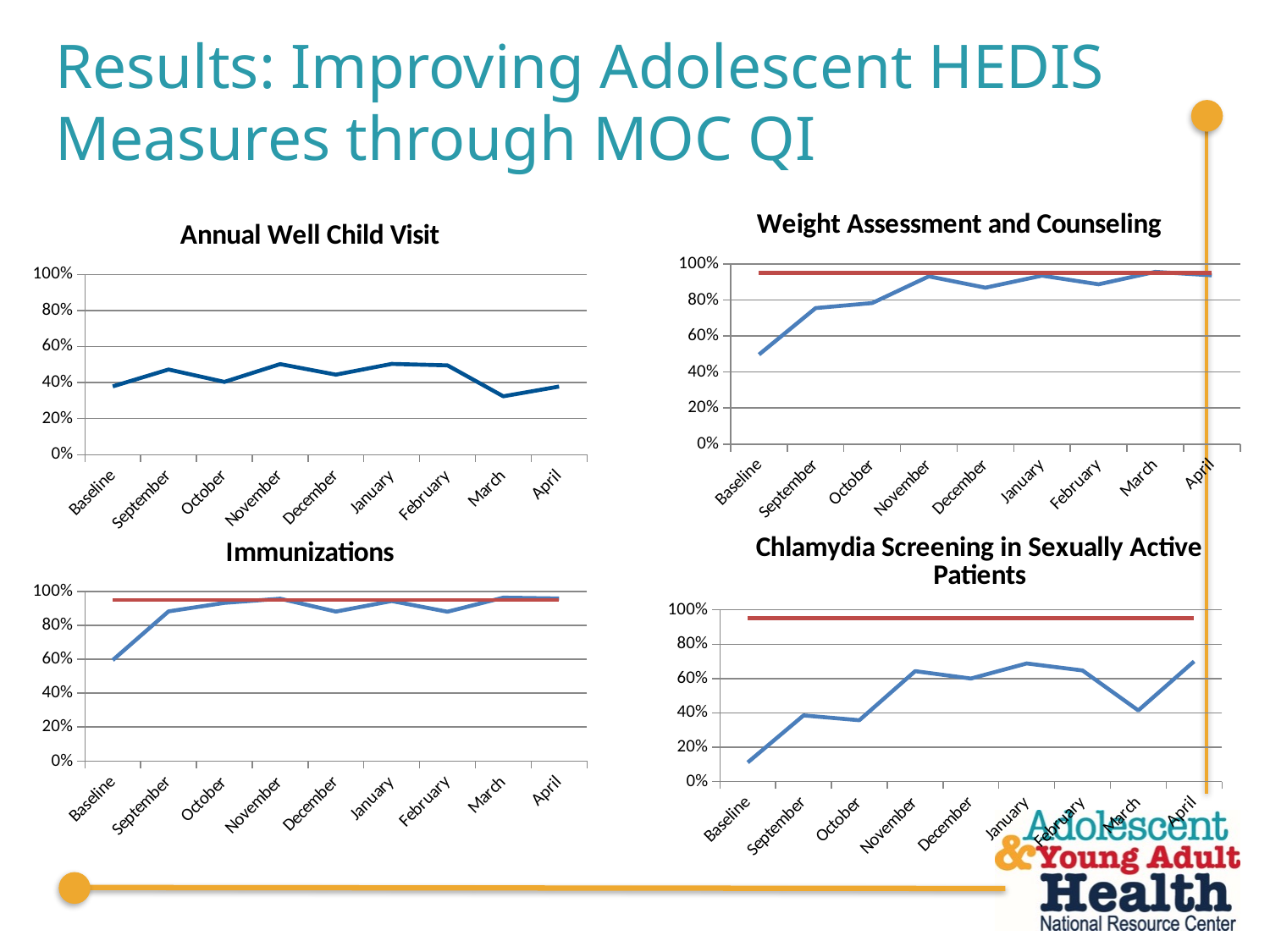
In the Annual Well Child Visit chart, is the value for March greater or less than 40%? less In the Immunizations chart, which point has the lowest value? Baseline In the Immunizations chart, is the Baseline value greater or less than 80%? less In the Weight Assessment and Counseling chart, is the Baseline value greater or less than 60%? less In the Weight Assessment and Counseling chart, which point has the lowest value? Baseline In the Annual Well Child Visit chart, which month has the lowest value? March What kind of chart is the Annual Well Child Visit chart? line chart In the Chlamydia Screening in Sexually Active Patients chart, do the values overall rise or fall from Baseline to April? rise How many time points are plotted on the x axis of the Immunizations chart? 9